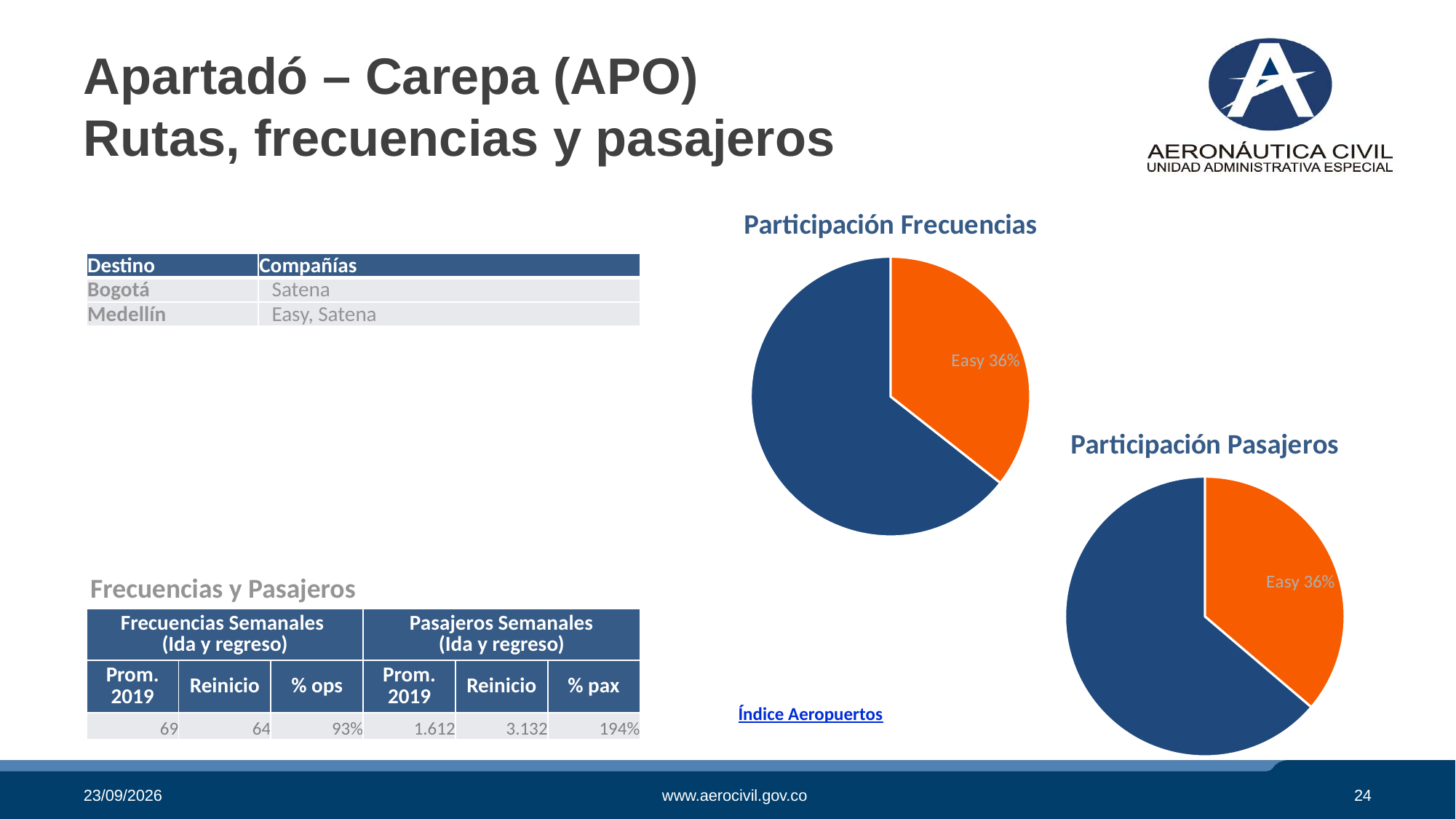
In the Participación Frecuencias chart, what share of the pie is not Easy? 64% In the Participación Frecuencias chart, is the Easy slice larger or smaller than the other slice? Smaller In the Participación Pasajeros chart, what share does Easy have? 36% How many slices does the Participación Pasajeros pie chart have? 2 In the Participación Frecuencias chart, what share does Easy have? 36% In the Participación Pasajeros chart, is the Easy slice larger or smaller than the other slice? Smaller What is the title of the pie chart in the lower right of the slide? Participación Pasajeros What kind of chart is Participación Pasajeros? Pie chart How many slices does the Participación Frecuencias pie chart have? 2 In the Participación Frecuencias chart, what colour is the Easy slice? Orange What kind of chart is Participación Frecuencias? Pie chart How many pie charts are shown on the slide? 2